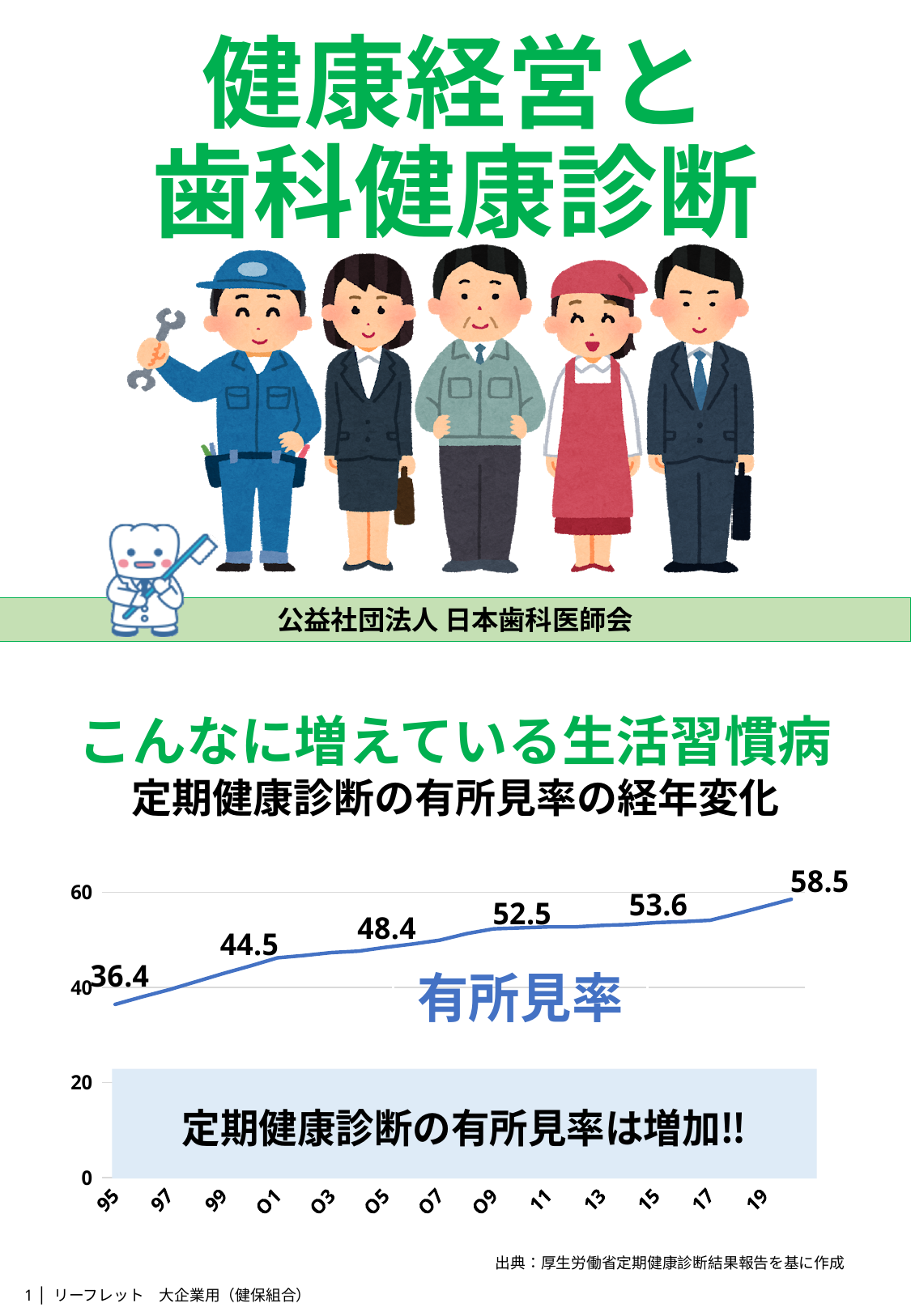
What is the lowest value labelled on the chart? 36.4 What is the name of the series plotted on the chart? 有所見率 What is the title of the chart? 定期健康診断の有所見率の経年変化 Does 有所見率 rise or fall from 95 to 19? rise How many year labels are shown on the x axis? 13 What is the highest value labelled on the chart? 58.5 Which is larger, the value at 95 or the value at 19? 19 What is the value of 有所見率 at the last point (19)? 58.5 Is the value for 95 greater or less than 40? less What kind of chart is shown on the slide? line chart What is the value of 有所見率 at the first point (95)? 36.4